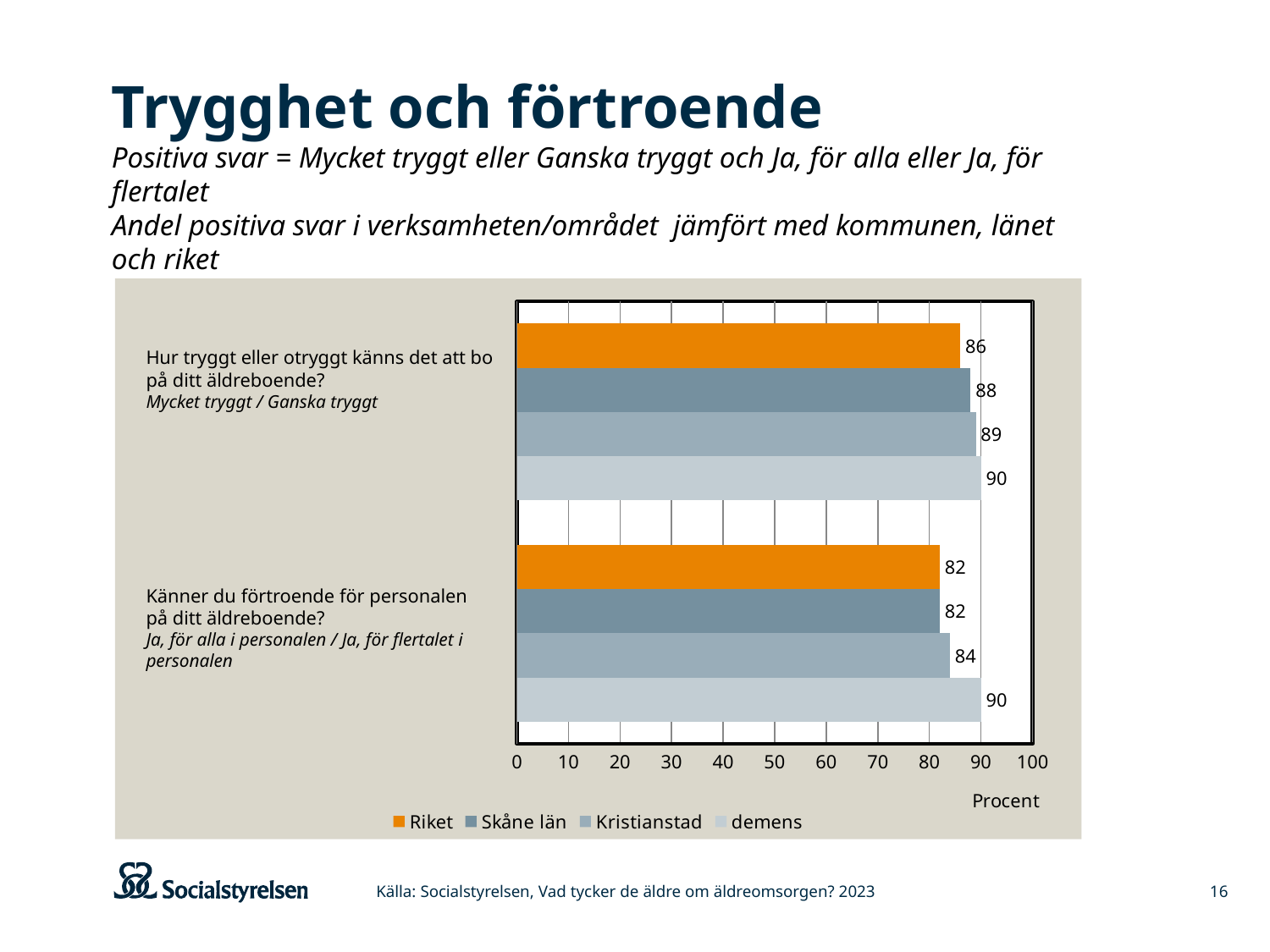
What is the value for Kristianstad on the question "Känner du förtroende för personalen på ditt äldreboende?"? 84 What is the value for Riket on the question "Hur tryggt eller otryggt känns det att bo på ditt äldreboende?"? 86 Which series has the lowest value on the question "Hur tryggt eller otryggt känns det att bo på ditt äldreboende?"? Riket What is the value for Skåne län on the question "Hur tryggt eller otryggt känns det att bo på ditt äldreboende?"? 88 How many question categories are shown on the chart? 2 What is the value for demens on the question "Känner du förtroende för personalen på ditt äldreboende?"? 90 What is the difference between the demens value and the Riket value on the question "Känner du förtroende för personalen på ditt äldreboende?"? 8 What kind of chart is shown on the slide? bar chart Which is larger on the question "Hur tryggt eller otryggt känns det att bo på ditt äldreboende?": the value for Kristianstad or the value for Riket? Kristianstad What label is shown on the horizontal axis of the chart? Procent Which series has the highest value on the question "Känner du förtroende för personalen på ditt äldreboende?"? demens How many series does the legend list? 4